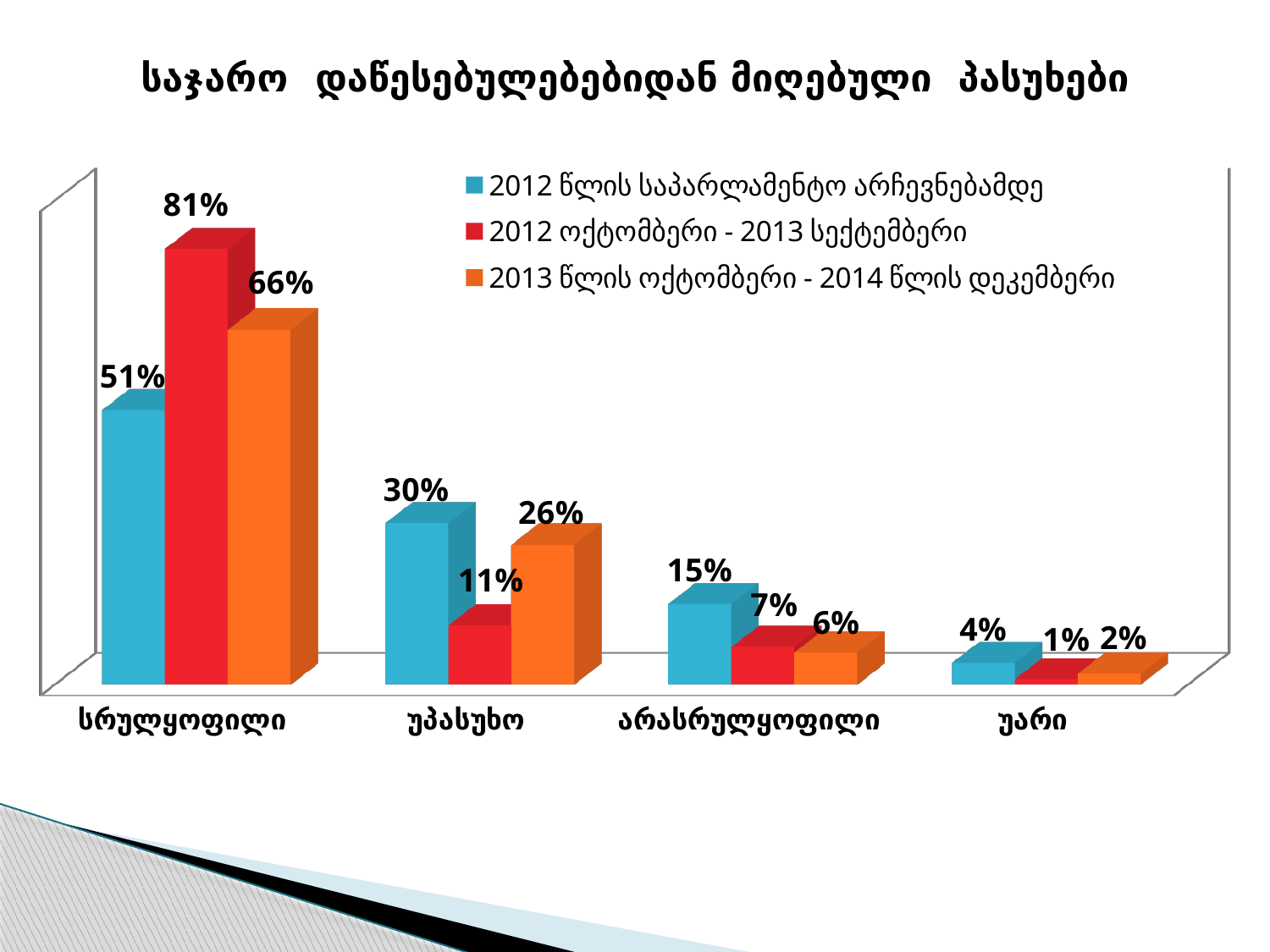
Do the values for the series 2013 წლის ოქტომბერი - 2014 წლის დეკემბერი rise or fall from სრულყოფილი to უარი? Fall What is the title of the chart? საჯარო დაწესებულებებიდან მიღებული პასუხები How many series does the legend list? 3 What is the value for არასრულყოფილი in the series 2012 წლის საპარლამენტო არჩევნებამდე? 15% What is the value for სრულყოფილი in the series 2012 ოქტომბერი - 2013 სექტემბერი? 81% What is the value for უპასუხო in the series 2013 წლის ოქტომბერი - 2014 წლის დეკემბერი? 26% What kind of chart is shown on the slide? Bar chart Which category has the highest value in the series 2012 წლის საპარლამენტო არჩევნებამდე? სრულყოფილი Which category has the lowest value in the series 2012 ოქტომბერი - 2013 სექტემბერი? უარი What is the difference between the 2012 ოქტომბერი - 2013 სექტემბერი value and the 2012 წლის საპარლამენტო არჩევნებამდე value for სრულყოფილი? 30% For უპასუხო, which series has the larger value: 2012 წლის საპარლამენტო არჩევნებამდე or 2012 ოქტომბერი - 2013 სექტემბერი? 2012 წლის საპარლამენტო არჩევნებამდე How many categories are shown on the x axis? 4